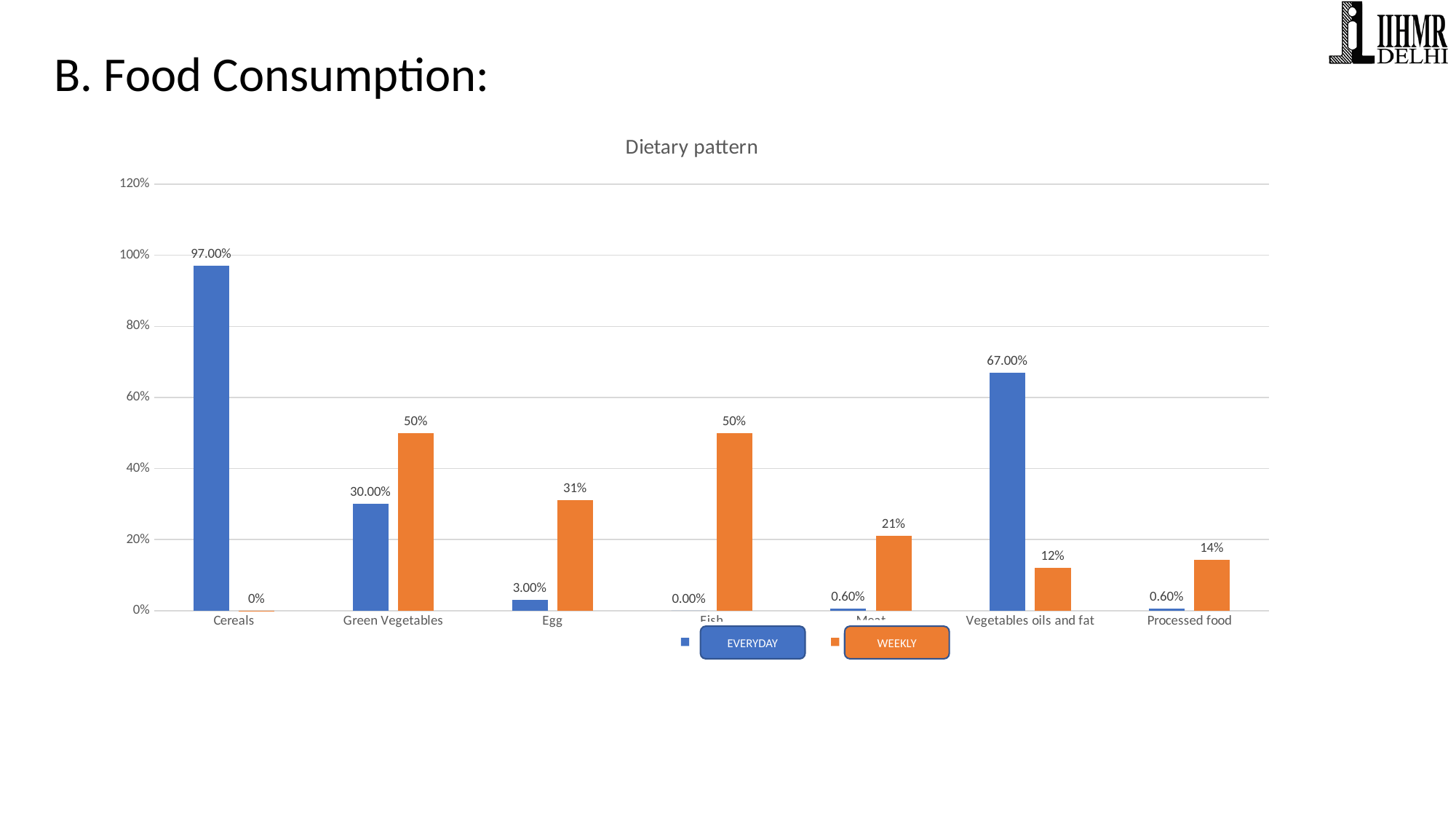
What is the WEEKLY value for Egg? 31% How many series does the legend list? 2 What is the EVERYDAY value for Cereals? 97.00% What type of chart is shown on the slide? Bar chart What is the EVERYDAY value for Vegetables oils and fat? 67.00% Which category has the lowest WEEKLY value? Cereals Which category has the highest EVERYDAY value? Cereals What is the difference between the WEEKLY and EVERYDAY values for Green Vegetables? 20% For Egg, which series has the larger value, EVERYDAY or WEEKLY? WEEKLY How many food categories are shown on the x axis? 7 What is the WEEKLY value for Processed food? 14% What is the WEEKLY value for Green Vegetables? 50%